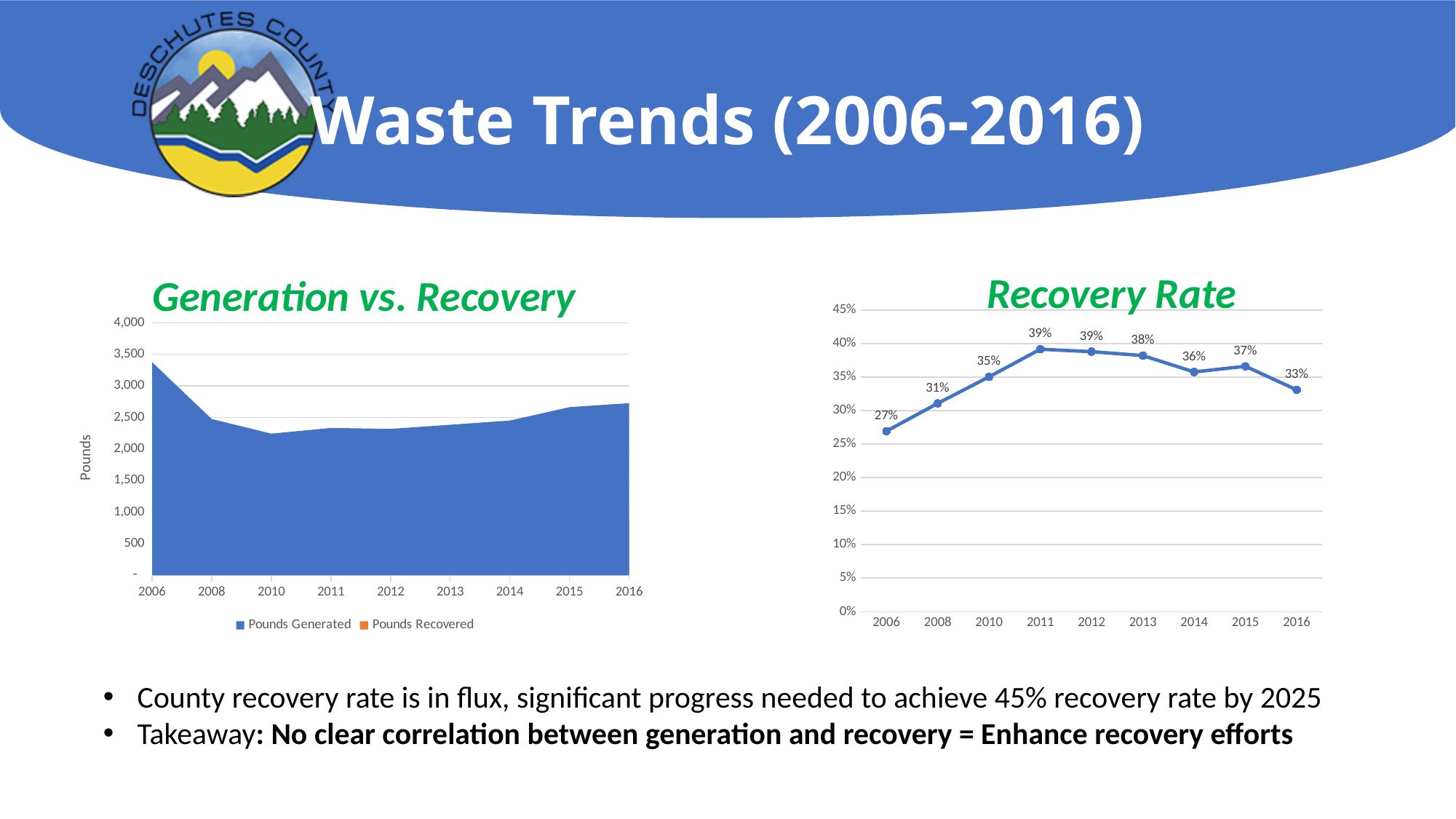
In the Recovery Rate chart, what was the recovery rate in 2016? 33% In the Generation vs. Recovery chart, how many series does the legend list? 2 In the Recovery Rate chart, how many years are plotted? 9 In the Recovery Rate chart, which year had a higher recovery rate, 2014 or 2015? 2015 In the Recovery Rate chart, what was the recovery rate in 2006? 27% In the Recovery Rate chart, did the recovery rate rise or fall from 2006 to 2011? rise In the Recovery Rate chart, what is the highest recovery rate shown? 39% In the Generation vs. Recovery chart, is the value for Pounds Generated in 2010 greater or less than 2,500? less In the Recovery Rate chart, what is the difference between the recovery rate in 2011 and in 2016? 6% In the Recovery Rate chart, what was the recovery rate in 2013? 38% In the Recovery Rate chart, which year had the lowest recovery rate? 2006 In the Generation vs. Recovery chart, is the value for Pounds Generated in 2006 greater or less than 3,000? greater